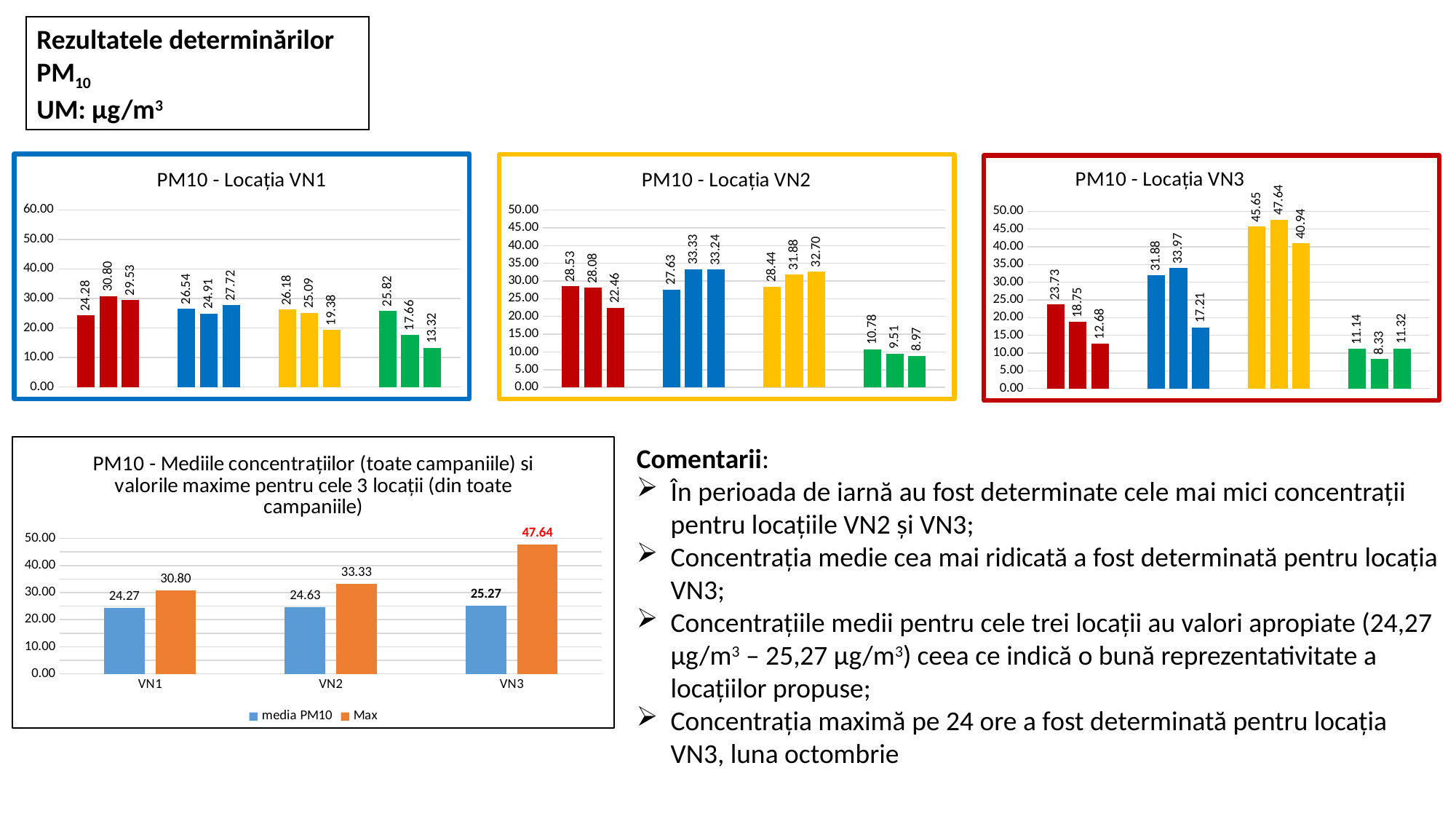
What kind of chart is 'PM10 - Locația VN1'? Bar chart In the bottom chart 'PM10 - Mediile concentrațiilor...', which has the larger media PM10 value, VN2 or VN3? VN3 How many locations are shown on the x axis of the bottom chart 'PM10 - Mediile concentrațiilor...'? 3 In the chart 'PM10 - Locația VN3', what is the highest value shown? 47.64 In the bottom chart 'PM10 - Mediile concentrațiilor...', which location has the highest Max value? VN3 How many series does the legend of the bottom chart 'PM10 - Mediile concentrațiilor...' list? 2 In the bottom chart 'PM10 - Mediile concentrațiilor...', what is the difference between the Max value and the media PM10 value for VN3? 22.37 In the chart 'PM10 - Locația VN2', what is the lowest value shown? 8.97 In the bottom chart 'PM10 - Mediile concentrațiilor...', what is the Max value for VN3? 47.64 In the bottom chart 'PM10 - Mediile concentrațiilor...', what is the difference between the Max values for VN2 and VN1? 2.53 In the bottom chart 'PM10 - Mediile concentrațiilor...', what is the media PM10 value for VN1? 24.27 What are the two legend entries in the bottom chart 'PM10 - Mediile concentrațiilor...'? media PM10 and Max